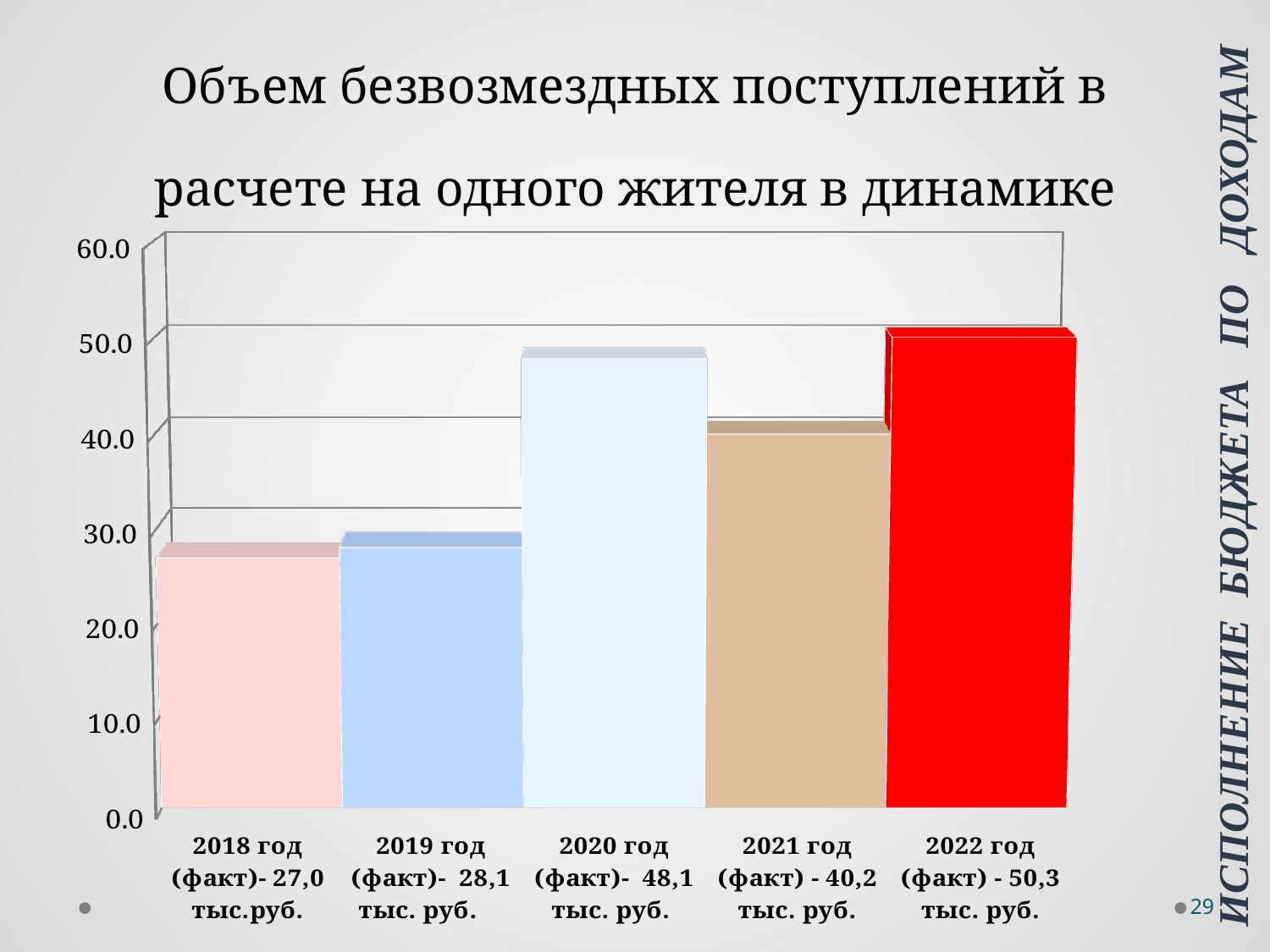
Which is larger, the value for 2020 год or the value for 2021 год? 2020 год Is the value for 2021 год greater or less than 30.0? greater What is the value for 2020 год (факт)? 48,1 тыс. руб. Which year has the lowest value? 2018 год How many bars (years) are shown in the chart? 5 Which year has the highest value? 2022 год What type of chart is shown on the slide? bar chart What is the value for 2022 год (факт)? 50,3 тыс. руб. What is the difference between the values for 2022 год and 2021 год? 10,1 тыс. руб. What is the title of the chart? Объем безвозмездных поступлений в расчете на одного жителя в динамике What is the value for 2018 год (факт)? 27,0 тыс.руб. Does the value rise or fall from 2020 год to 2021 год? fall